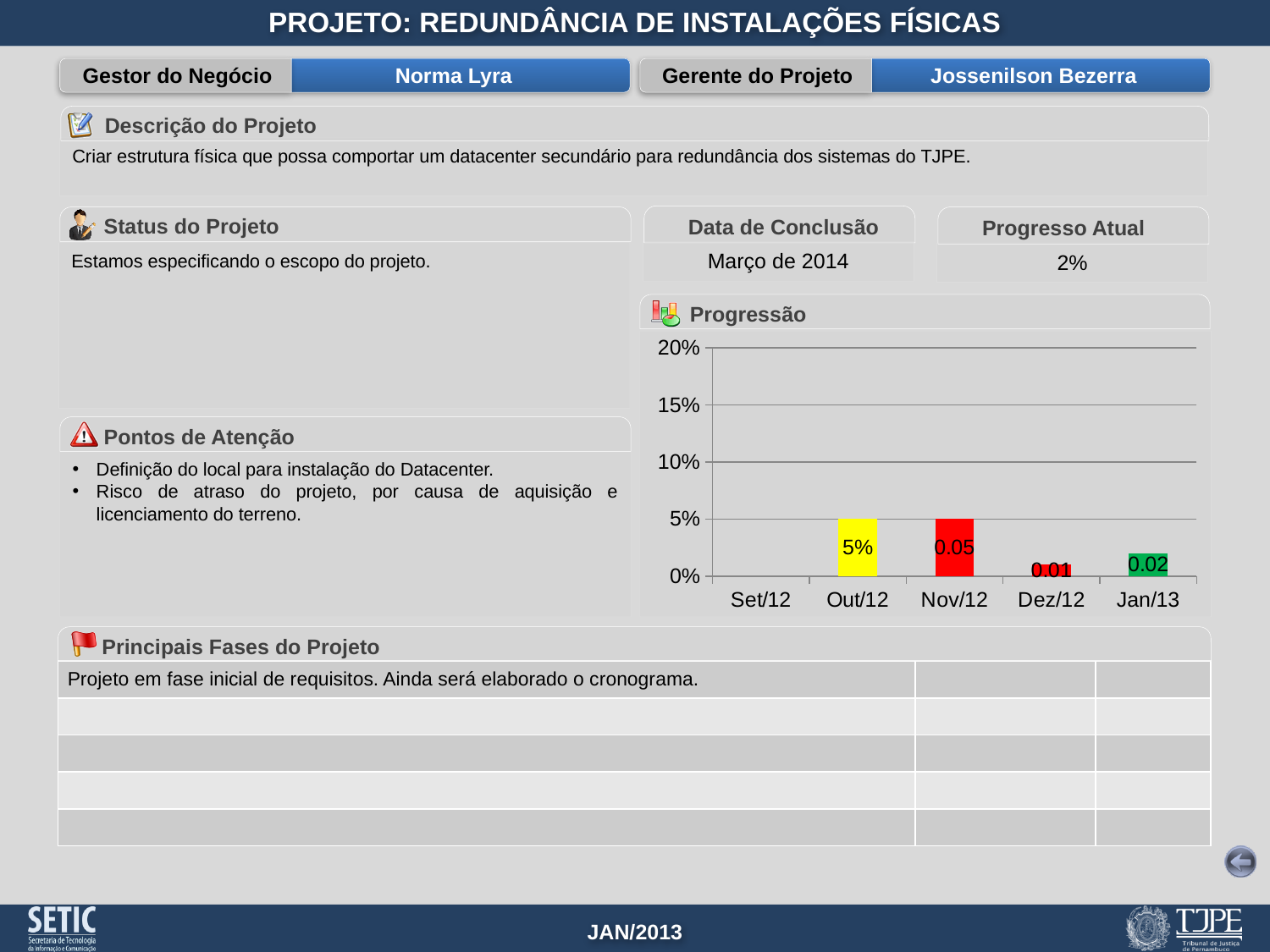
How many categories are shown on the x axis of the Progressão chart? 5 In the Progressão chart, which is larger, the value for Nov/12 or the value for Dez/12? Nov/12 In the Progressão chart, what is the data label on the Dez/12 bar? 0.01 In the Progressão chart, what is the value shown for Out/12? 5% In the Progressão chart, which is larger, the value for Jan/13 or the value for Dez/12? Jan/13 What kind of chart is the Progressão chart? bar chart In the Progressão chart, what is the data label on the Jan/13 bar? 0.02 What colour is the Out/12 bar in the Progressão chart? yellow In the Progressão chart, do the values rise or fall from Nov/12 to Dez/12? fall In the Progressão chart, is the value for Out/12 greater or less than 10%? less In the Progressão chart, what is the difference between the Jan/13 label (0.02) and the Dez/12 label (0.01)? 0.01 In the Progressão chart, what is the data label on the Nov/12 bar? 0.05